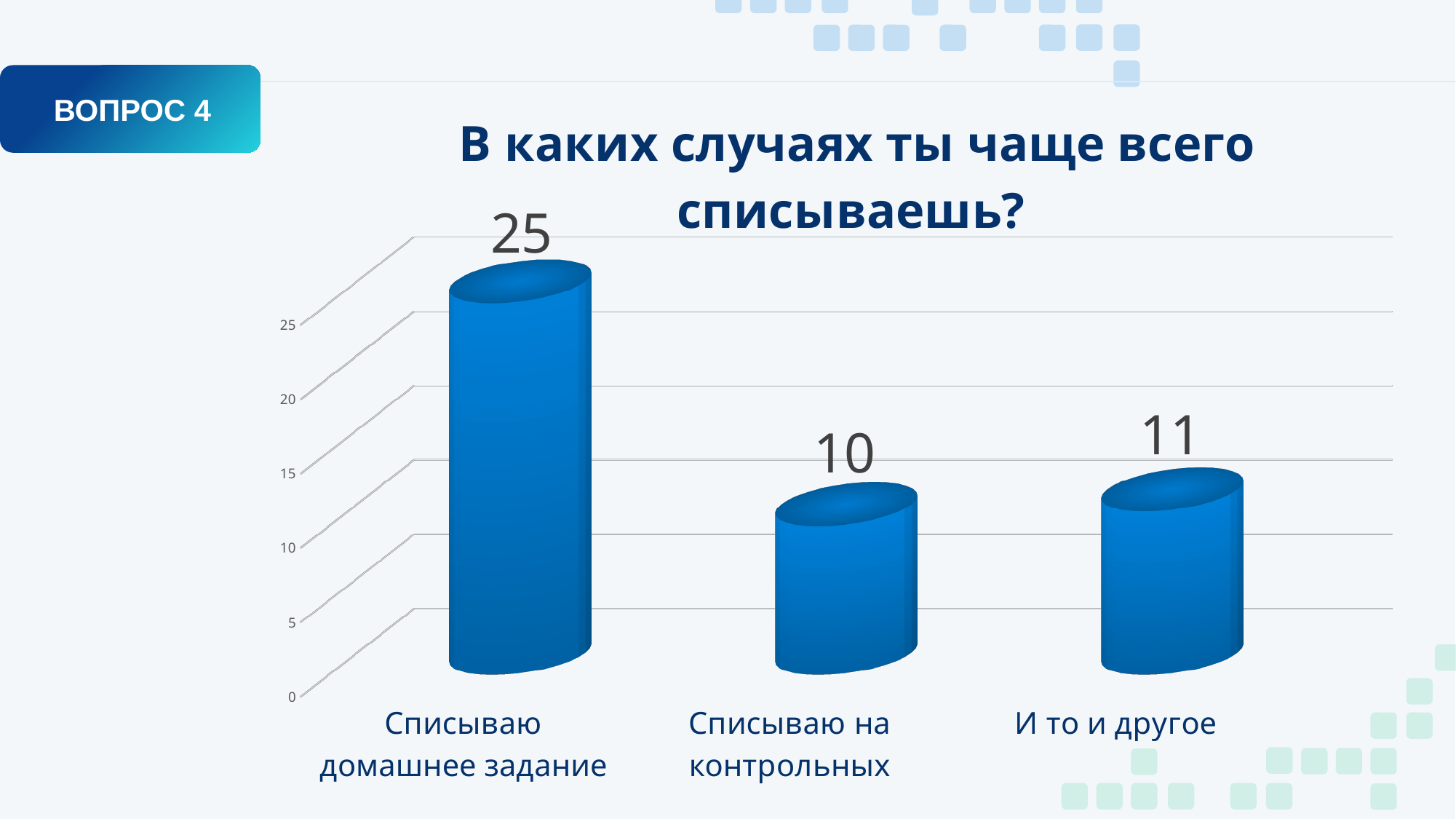
Is the value for "Списываю домашнее задание" greater or less than 20? greater Which category has the lowest value? Списываю на контрольных Which category has the highest value? Списываю домашнее задание What kind of chart is shown on the slide? bar chart How many categories are shown in the chart? 3 What is the title of the chart? В каких случаях ты чаще всего списываешь? What is the value for "Списываю домашнее задание"? 25 What is the difference between the values for "И то и другое" and "Списываю на контрольных"? 1 What is the difference between the values for "Списываю домашнее задание" and "Списываю на контрольных"? 15 Which is larger: the value for "Списываю домашнее задание" or the value for "И то и другое"? Списываю домашнее задание What is the value for "Списываю на контрольных"? 10 What is the value for "И то и другое"? 11